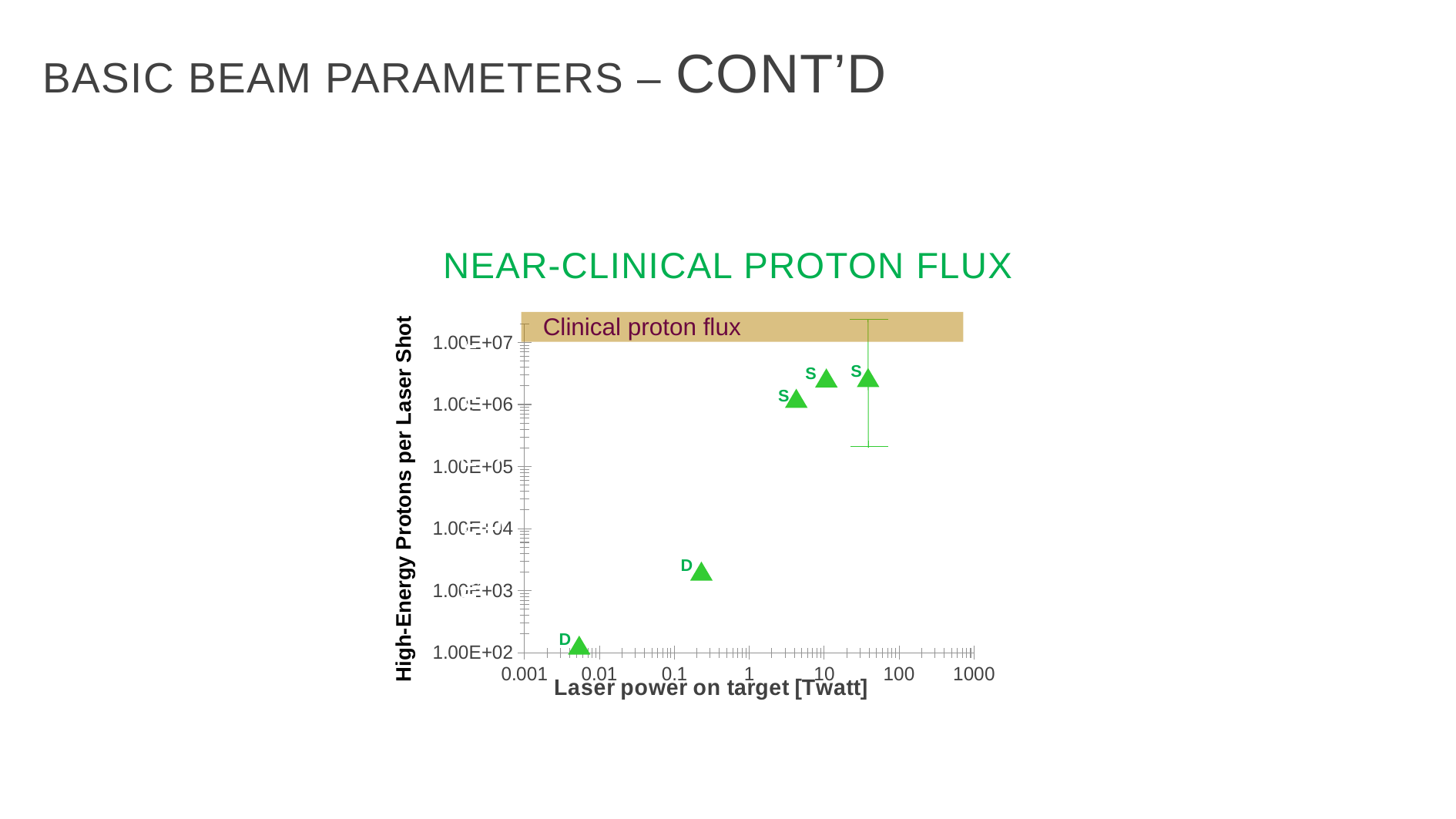
Do the plotted values rise or fall as laser power on target increases? rise Which label (D or S) marks the points with the highest number of high-energy protons per laser shot? S How many data points are plotted on the chart? 5 How many of the plotted points are labelled "S"? 3 Is the value for the D point near 0.2 Twatt greater or less than 1.00E+04 protons per laser shot? less Are the S points greater or less than 1.00E+07 protons per laser shot? less Is the value for the D point near 0.2 Twatt greater or less than 1.00E+03 protons per laser shot? greater Which label (D or S) marks the point with the lowest number of high-energy protons per laser shot? D What kind of chart is shown on the slide? scatter chart What is the title of the chart? NEAR-CLINICAL PROTON FLUX How many of the plotted points are labelled "D"? 2 What is the label of the shaded band at the top of the chart? Clinical proton flux